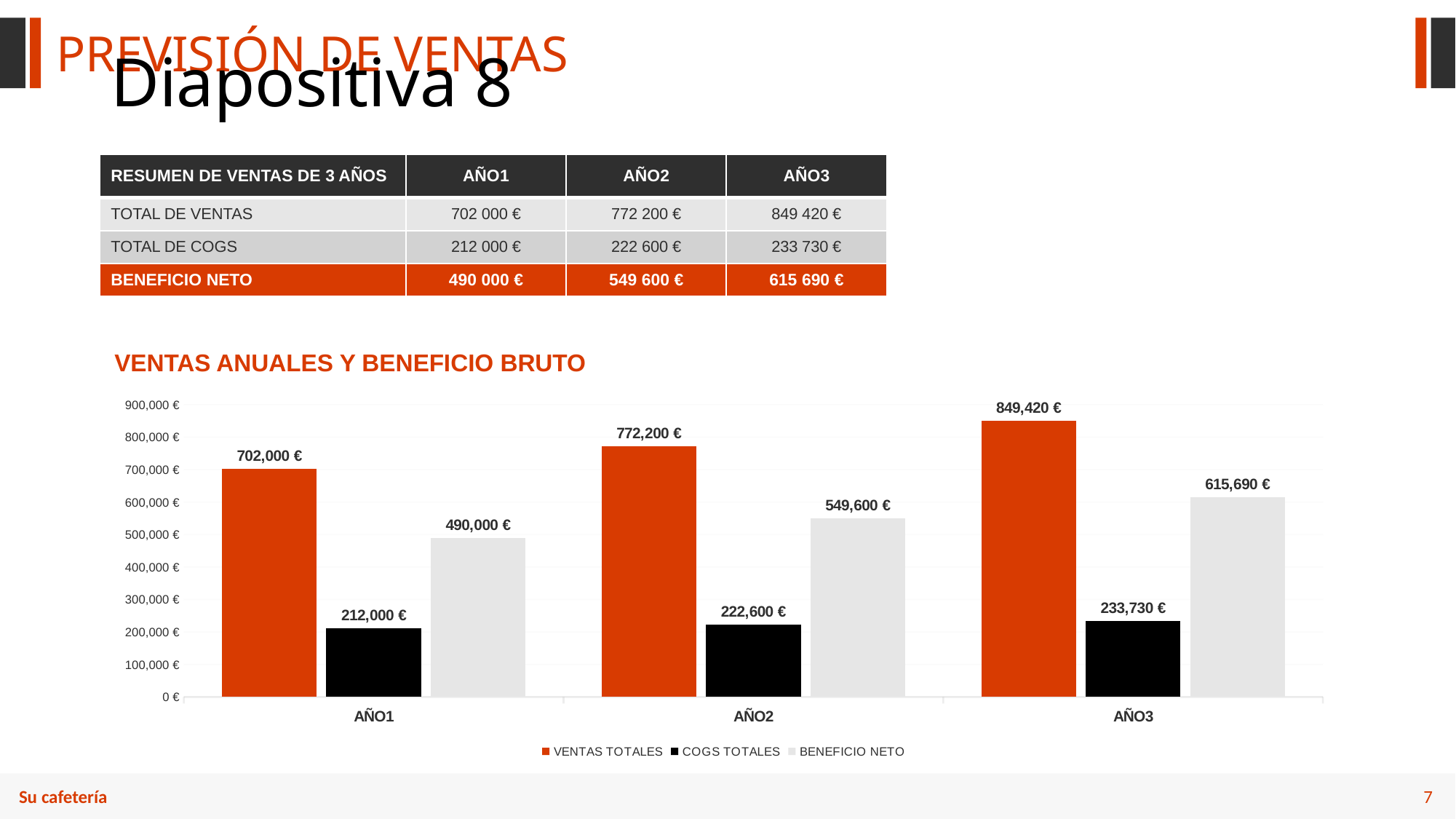
Which year has the lowest COGS TOTALES in the chart? AÑO1 What type of chart is shown on the slide? Bar chart What is the value of BENEFICIO NETO for AÑO1 in the chart? 490,000 € What is the difference between BENEFICIO NETO for AÑO3 and AÑO2 in the chart? 66,090 € What is the value of VENTAS TOTALES for AÑO2 in the chart? 772,200 € Do the VENTAS TOTALES values rise or fall from AÑO1 to AÑO3 in the chart? Rise How many year categories are shown on the x axis of the chart? 3 What is the difference between VENTAS TOTALES and COGS TOTALES for AÑO1 in the chart? 490,000 € Which year has the highest VENTAS TOTALES in the chart? AÑO3 What is the value of COGS TOTALES for AÑO3 in the chart? 233,730 € Which is larger in the chart: BENEFICIO NETO for AÑO2 or VENTAS TOTALES for AÑO1? VENTAS TOTALES for AÑO1 How many series does the chart legend list? 3